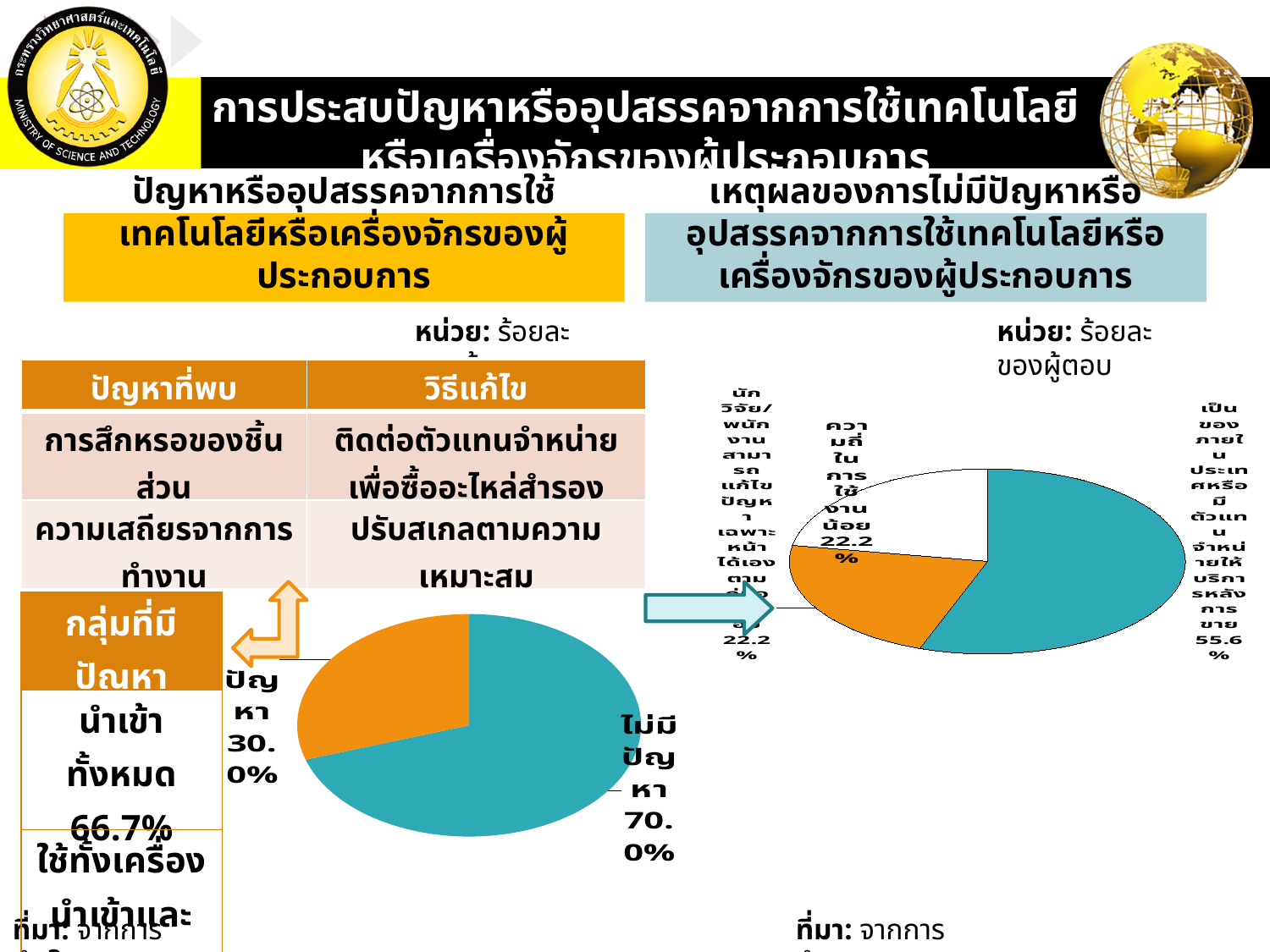
In the left pie chart, which slice is larger: 'ปัญหา' or 'ไม่มีปัญหา'? ไม่มีปัญหา What type of chart is shown on the right side of the slide under the heading 'เหตุผลของการไม่มีปัญหาหรืออุปสรรคจากการใช้เทคโนโลยีหรือเครื่องจักรของผู้ประกอบการ'? Pie chart In the right pie chart, which slice is the largest? เป็นของภายในประเทศหรือมีตัวแทนจำหน่ายให้บริการหลังการขาย How many slices does the right pie chart have? 3 What unit is stated above the right pie chart? ร้อยละของผู้ตอบ In the right pie chart, what percentage is shown for 'ความถี่ในการใช้งานน้อย'? 22.2% In the left pie chart, what percentage is shown for 'ไม่มีปัญหา'? 70.0% In the left pie chart, what is the difference in percentage points between 'ไม่มีปัญหา' and 'ปัญหา'? 40.0 percentage points In the right pie chart, what percentage is shown for the slice 'เป็นของภายในประเทศหรือมีตัวแทนจำหน่ายให้บริการหลังการขาย'? 55.6% How many slices does the left pie chart have? 2 What type of chart is shown on the left side of the slide under the heading 'ปัญหาหรืออุปสรรคจากการใช้เทคโนโลยีหรือเครื่องจักรของผู้ประกอบการ'? Pie chart In the left pie chart, what percentage is shown for 'ปัญหา'? 30.0%